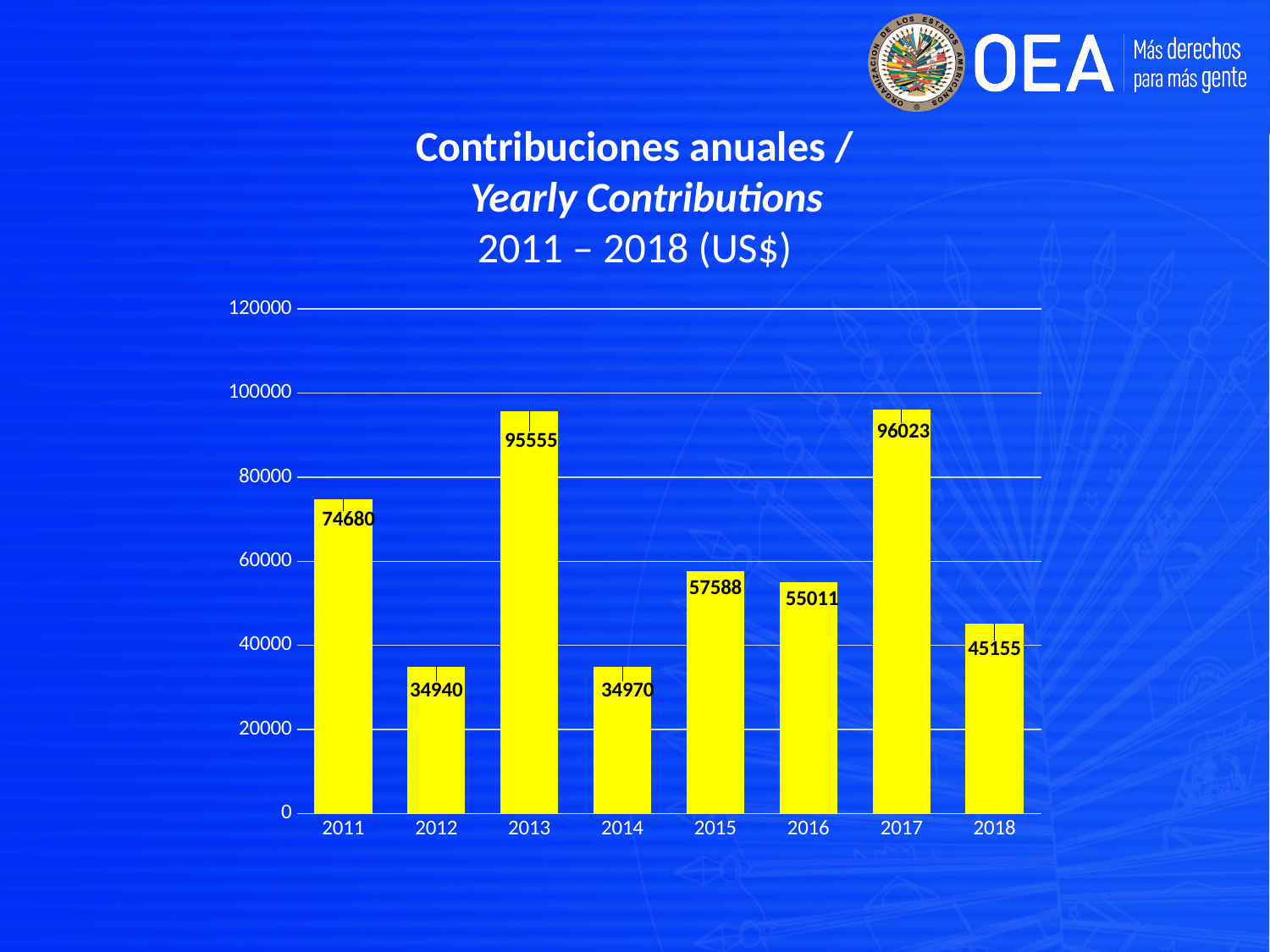
What colour are the bars in the chart? Yellow Which year had a larger contribution, 2015 or 2016? 2015 What value is shown for 2018? 45155 What was the contribution in 2015? 57588 What kind of chart is shown on the slide? Bar chart How many years are shown on the x axis? 8 What was the yearly contribution in 2013? 95555 Is the value for 2016 greater or less than 40000? greater Did the contribution rise or fall from 2011 to 2012? Fall What is the difference between the 2011 and 2018 contributions? 29525 What is the difference between the 2017 and 2013 contributions? 468 Which year had the highest contribution? 2017